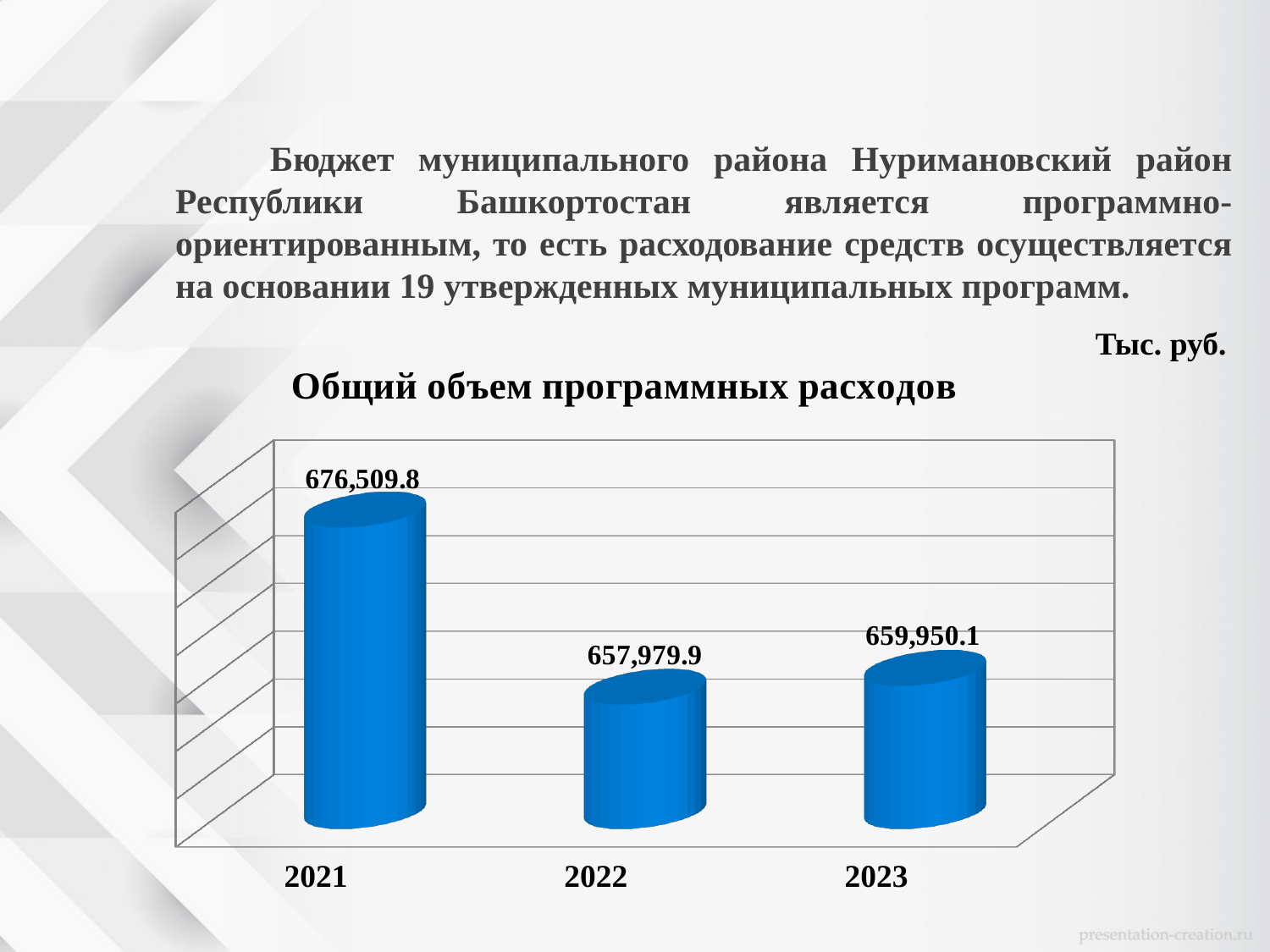
What is the value for 2022 in the chart? 657,979.9 Which year has the lowest value in the chart? 2022 Which year has the highest value in the chart? 2021 What is the value for 2021 in the chart 'Общий объем программных расходов'? 676,509.8 What is the value for 2023 in the chart? 659,950.1 What is the title of the chart on the slide? Общий объем программных расходов What kind of chart is shown on the slide? bar chart Did the value rise or fall from 2021 to 2022? fall What is the difference between the values for 2021 and 2022? 18,529.9 Which is larger, the value for 2022 or the value for 2023? 2023 How many years are shown on the x axis of the chart? 3 What is the difference between the values for 2023 and 2022? 1,970.2